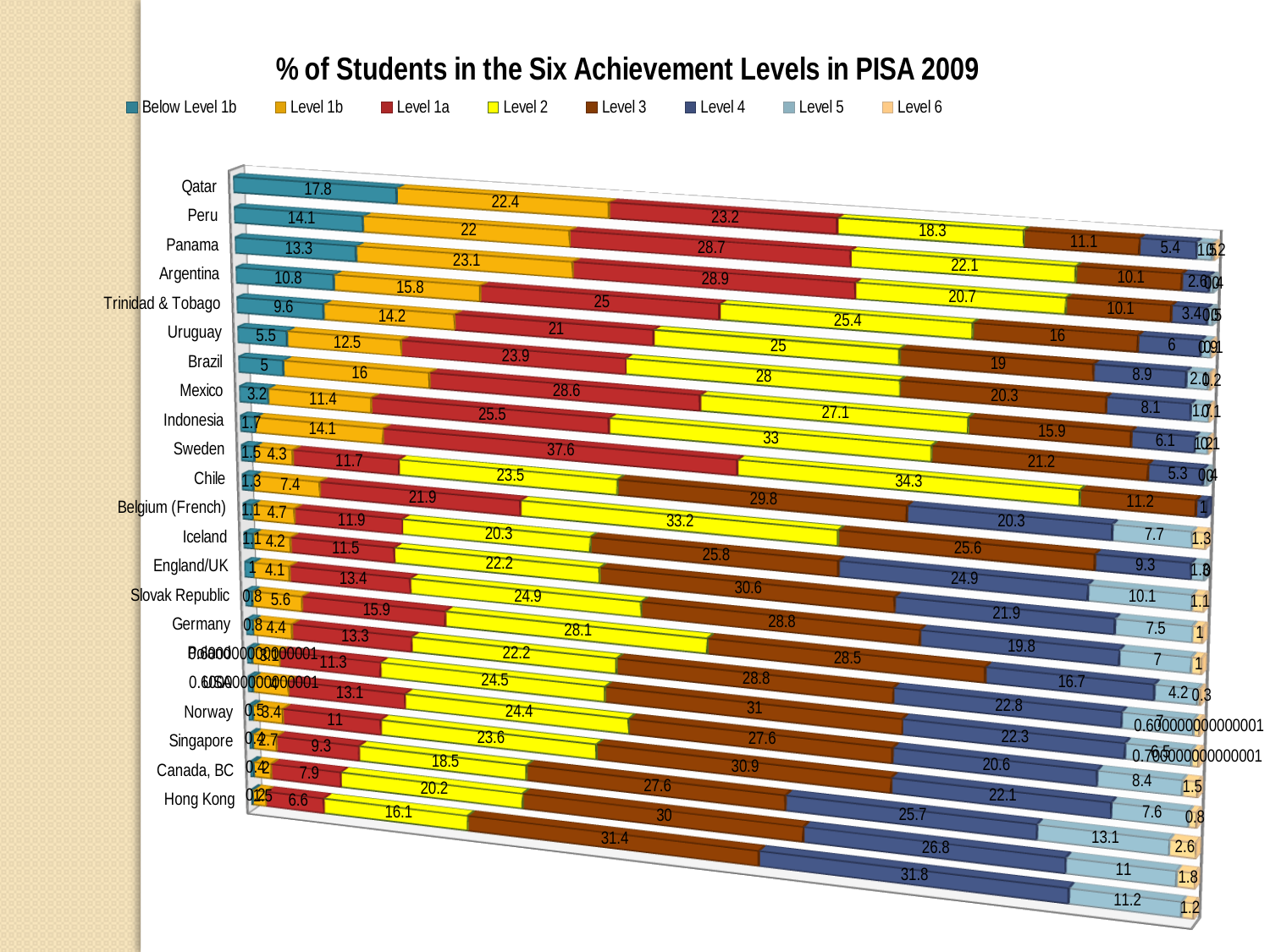
What kind of chart is shown on the slide? Stacked bar chart What is the difference between the Below Level 1b values for Qatar and Peru? 3.7 Which has the larger Below Level 1b value, Qatar or Peru? Qatar How many series does the legend list? 8 What is the Level 1b value for Peru? 22 Which country has the highest Below Level 1b value? Qatar What is the Below Level 1b value for Argentina? 10.8 What is the title of the chart? % of Students in the Six Achievement Levels in PISA 2009 What is the Below Level 1b value for Panama? 13.3 What is the Below Level 1b value for Qatar? 17.8 What is the Below Level 1b value for Mexico? 3.2 How many countries/regions are plotted on the chart? 22